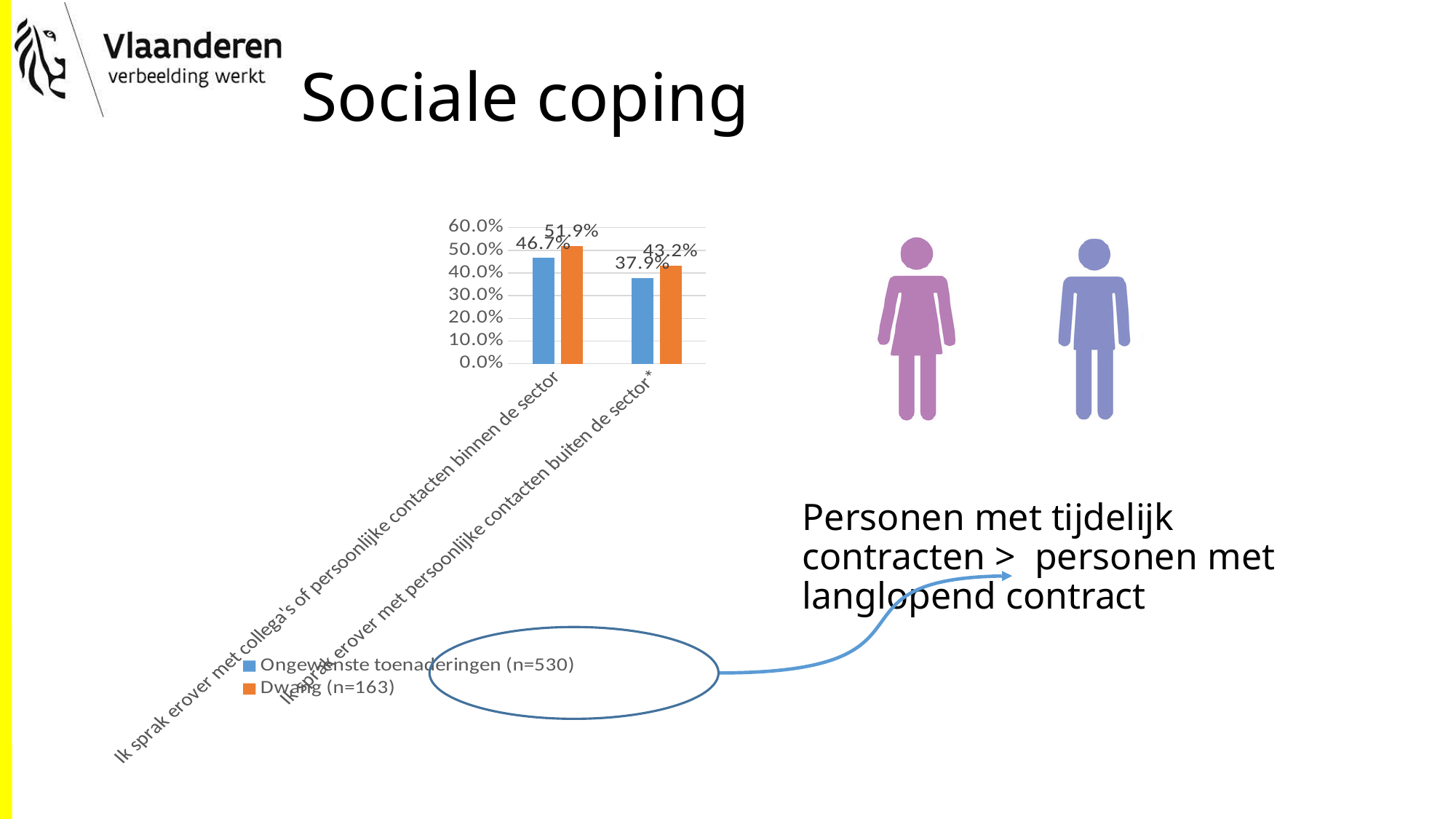
Which bar in the chart has the lowest value? Ongewenste toenaderingen (n=530) for 'Ik sprak erover met persoonlijke contacten buiten de sector*' For 'Ik sprak erover met persoonlijke contacten buiten de sector*', which series has the larger value: Ongewenste toenaderingen (n=530) or Dwang (n=163)? Dwang (n=163) What is the value for Dwang (n=163) for 'Ik sprak erover met collega's of persoonlijke contacten binnen de sector'? 51.9% Which bar in the chart has the highest value? Dwang (n=163) for 'Ik sprak erover met collega's of persoonlijke contacten binnen de sector' How many series does the chart legend list? 2 What type of chart is shown on the slide? Bar chart How many categories are shown on the x axis of the chart? 2 What is the difference between the Dwang (n=163) and Ongewenste toenaderingen (n=530) values for 'Ik sprak erover met collega's of persoonlijke contacten binnen de sector'? 5.2% What is the value for Ongewenste toenaderingen (n=530) for 'Ik sprak erover met persoonlijke contacten buiten de sector*'? 37.9% What is the value for Dwang (n=163) for 'Ik sprak erover met persoonlijke contacten buiten de sector*'? 43.2% What is the difference between the Ongewenste toenaderingen (n=530) values for the two categories? 8.8% What is the value for Ongewenste toenaderingen (n=530) for 'Ik sprak erover met collega's of persoonlijke contacten binnen de sector'? 46.7%